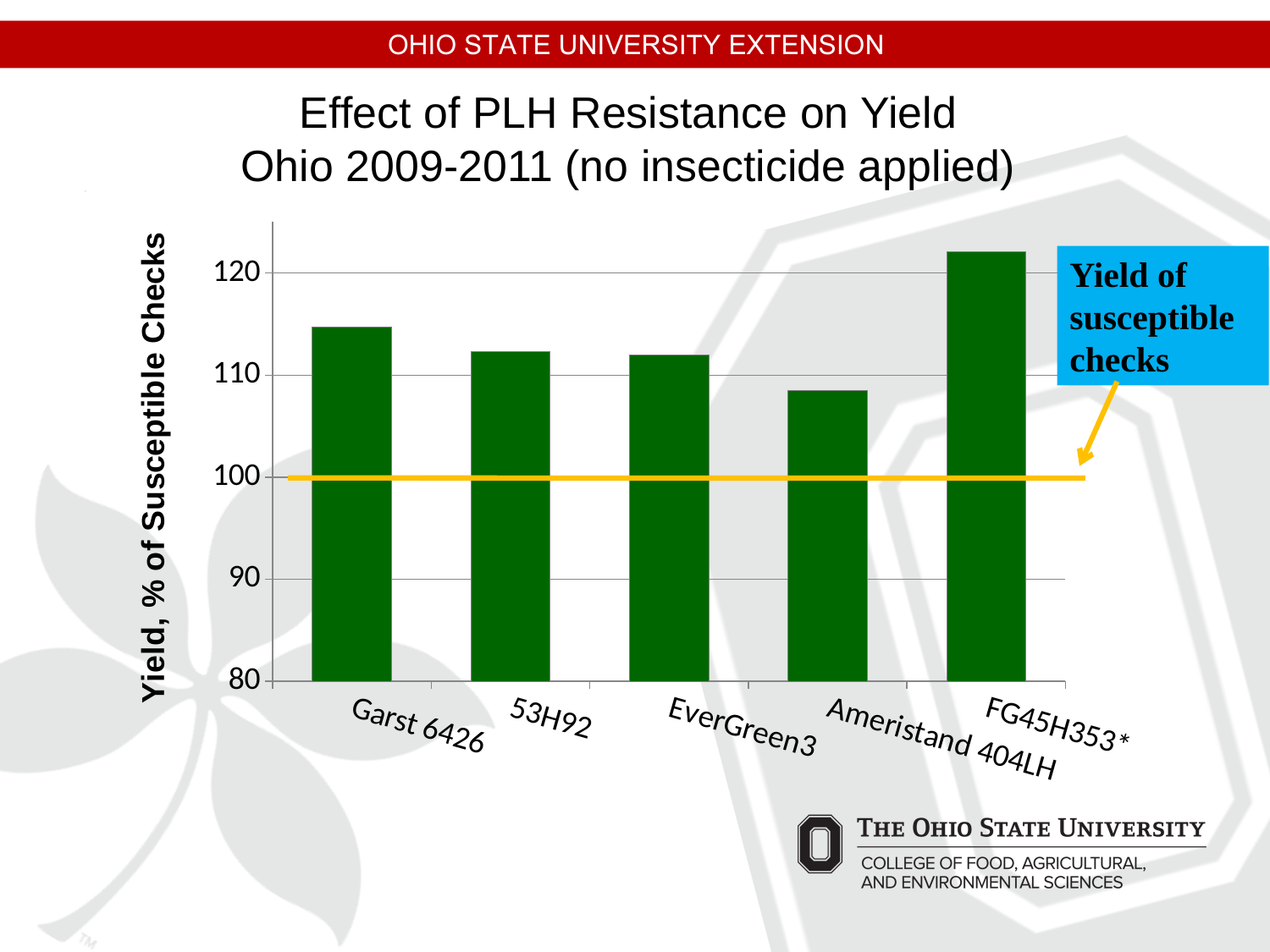
Is the value for Ameristand 404LH greater or less than 110? less Is the value for Garst 6426 greater or less than 110? greater Is the value for FG45H353* greater or less than 120? greater Which has a higher yield as a percent of susceptible checks, Garst 6426 or Ameristand 404LH? Garst 6426 What is the label on the vertical axis of the chart? Yield, % of Susceptible Checks At what value on the vertical axis is the yellow horizontal line marking the yield of susceptible checks drawn? 100 Which variety has the highest yield as a percent of susceptible checks? FG45H353* Which variety has the lowest yield as a percent of susceptible checks? Ameristand 404LH What kind of chart is shown on the slide? bar chart Which has a higher yield as a percent of susceptible checks, FG45H353* or EverGreen3? FG45H353* How many varieties (bars) are plotted in the chart? 5